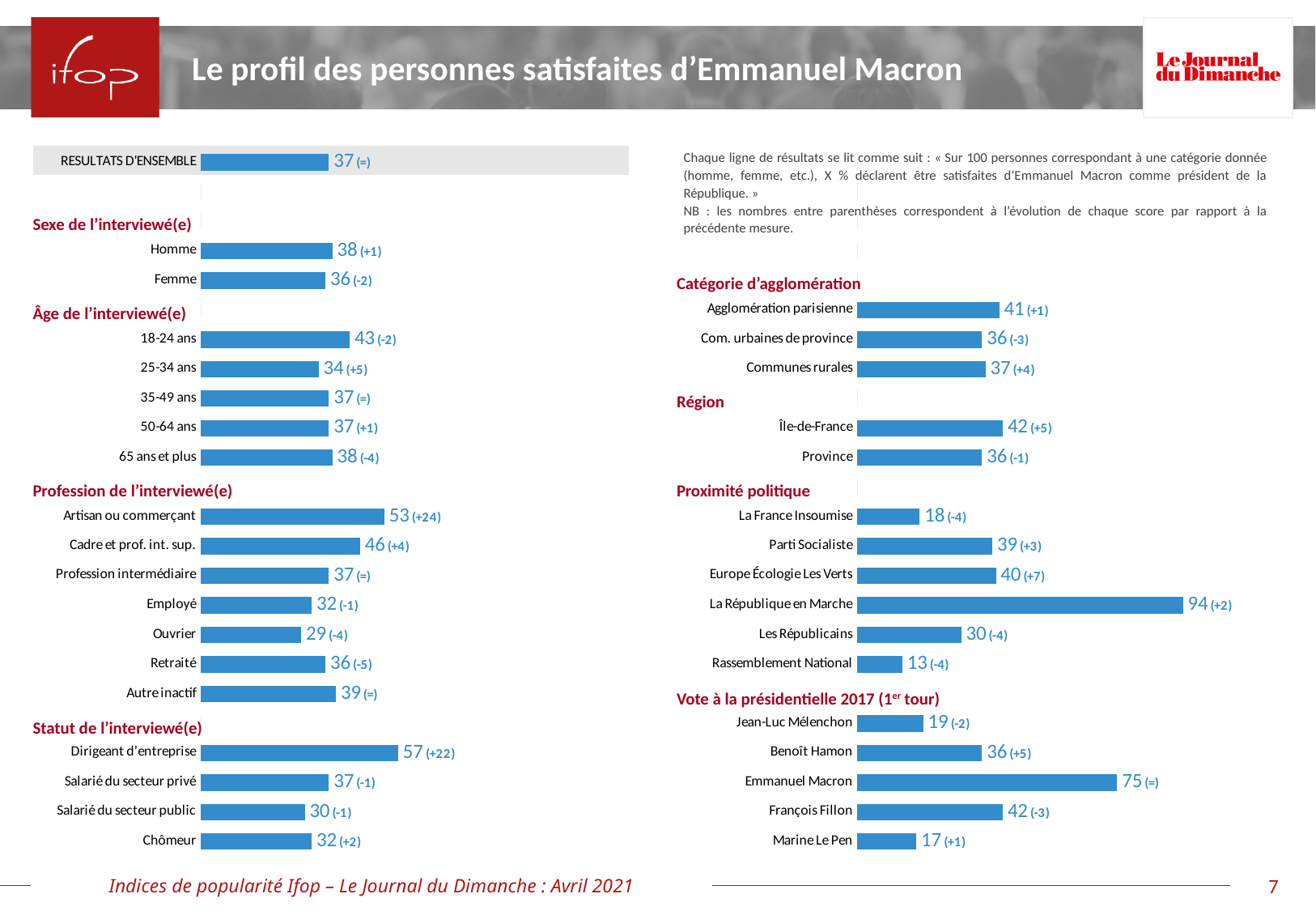
In the "Proximité politique" chart, which category has the lowest value? Rassemblement National In the "Profession de l'interviewé(e)" chart, what evolution is shown in parentheses next to Artisan ou commerçant? +24 What is the value shown for RESULTATS D'ENSEMBLE at the top of the left chart? 37 In the "Sexe de l'interviewé(e)" chart, what is the value for Femme? 36 In the "Proximité politique" chart, what is the value for La République en Marche? 94 How many categories are shown in the "Profession de l'interviewé(e)" chart? 7 In the "Statut de l'interviewé(e)" chart, what is the value for Dirigeant d'entreprise? 57 In the "Âge de l'interviewé(e)" chart, which is larger, the value for 18-24 ans or for 25-34 ans? 18-24 ans What kind of chart is used on this slide to show the satisfaction scores? bar chart In the "Région" chart, what is the difference between the values for Île-de-France and Province? 6 In the "Vote à la présidentielle 2017 (1er tour)" chart, what is the difference between the values for Emmanuel Macron and Marine Le Pen? 58 In the "Profession de l'interviewé(e)" chart, which category has the highest value? Artisan ou commerçant